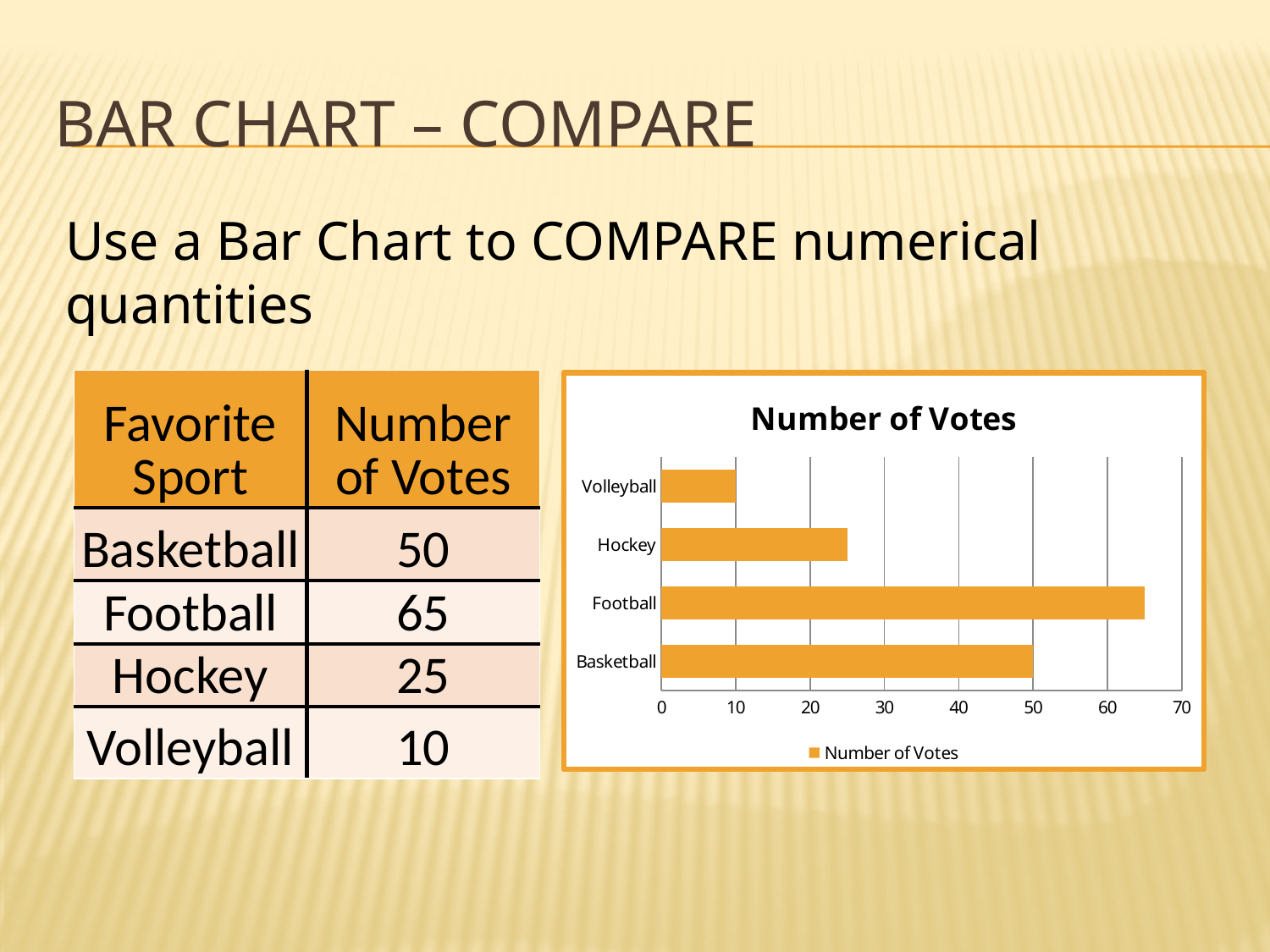
What is the number of votes for Hockey? 25 What is the title of the chart? Number of Votes Is the value for Football greater or less than 60? greater Which sport has the highest number of votes? Football What is the difference in votes between Football and Basketball? 15 Which sport has the lowest number of votes? Volleyball Which has more votes, Hockey or Volleyball? Hockey What is the number of votes for Basketball? 50 How many series does the chart legend list? 1 How many sports are plotted in the chart? 4 What type of chart is shown on the slide? bar chart What is the number of votes for Football? 65